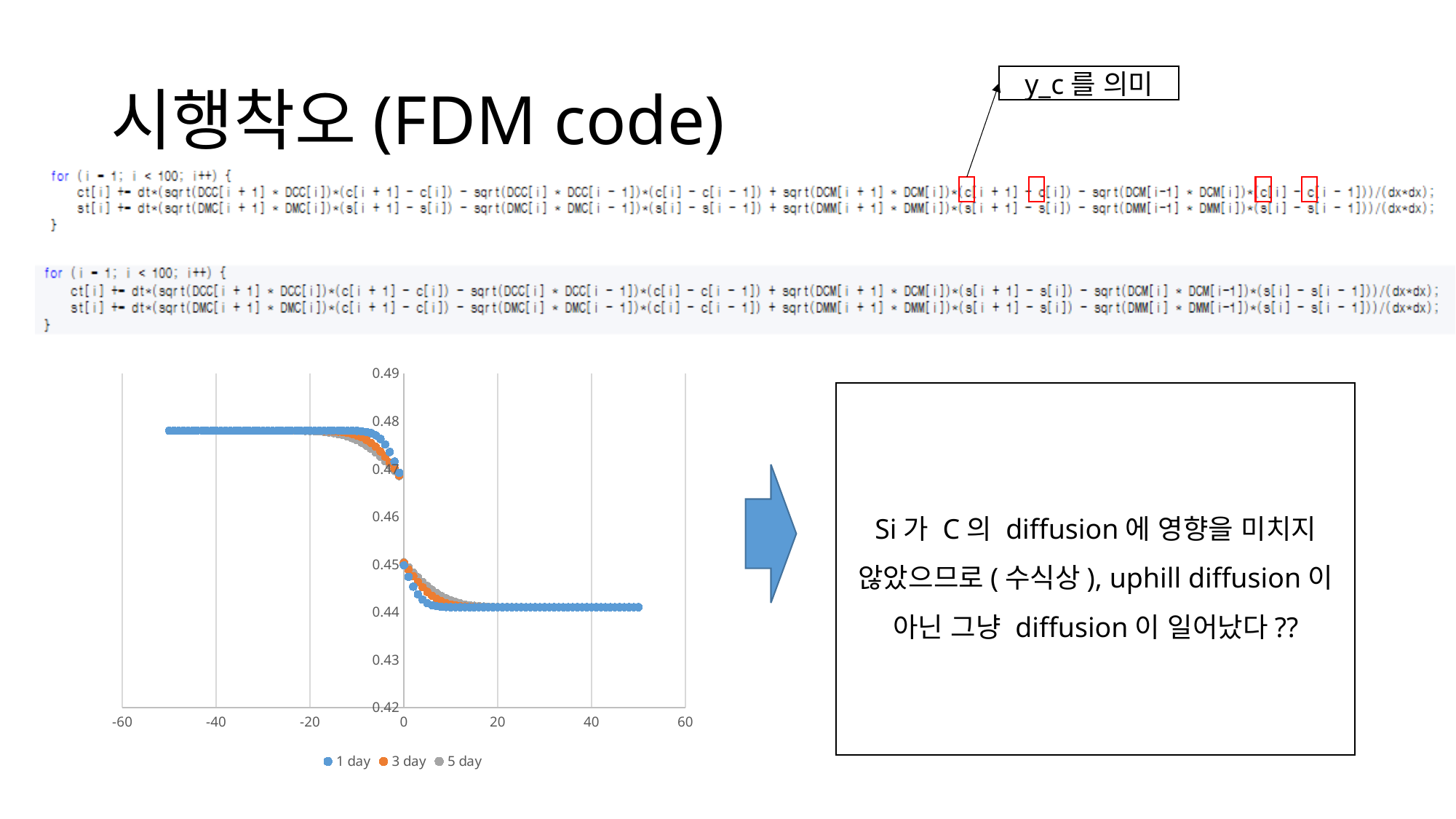
Is the value of the 5 day series at x = -40 greater or less than 0.48? less Which is larger for the 1 day series: the value at x = -40 or the value at x = 40? the value at x = -40 What are the series names listed in the chart legend? 1 day, 3 day, 5 day Is the value of the 3 day series at x = 20 greater or less than 0.46? less How many series does the chart legend list? 3 What kind of chart is shown on the slide? scatter chart What is the maximum value shown on the chart's y axis? 0.49 Is the value of the 1 day series at x = 40 greater or less than 0.45? less Do the plotted values rise or fall as x increases from -60 to 60? fall